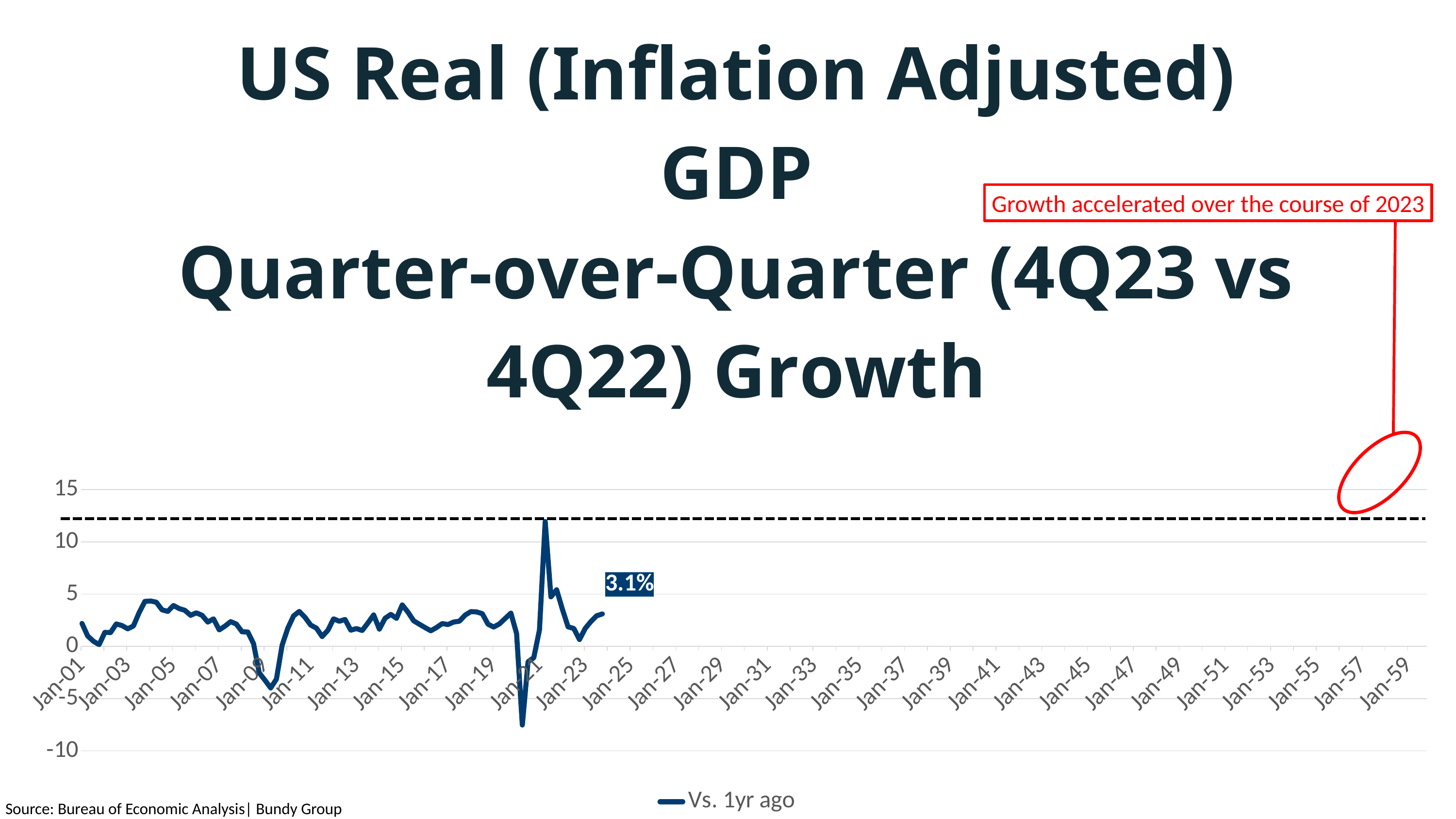
Does the line rise or fall over the course of 2023, from Jan-23 to the final labelled point? rise Is the final labelled value of 3.1% greater or less than 5? less What value is printed as the data label at the end of the line? 3.1% What kind of chart is shown on the slide? line chart Is the highest value reached by the line greater or less than 10? greater What is the highest value shown on the vertical axis? 15 Is the lowest value reached by the line greater or less than -5? less What is the name of the series shown in the legend? Vs. 1yr ago How many series does the legend list? 1